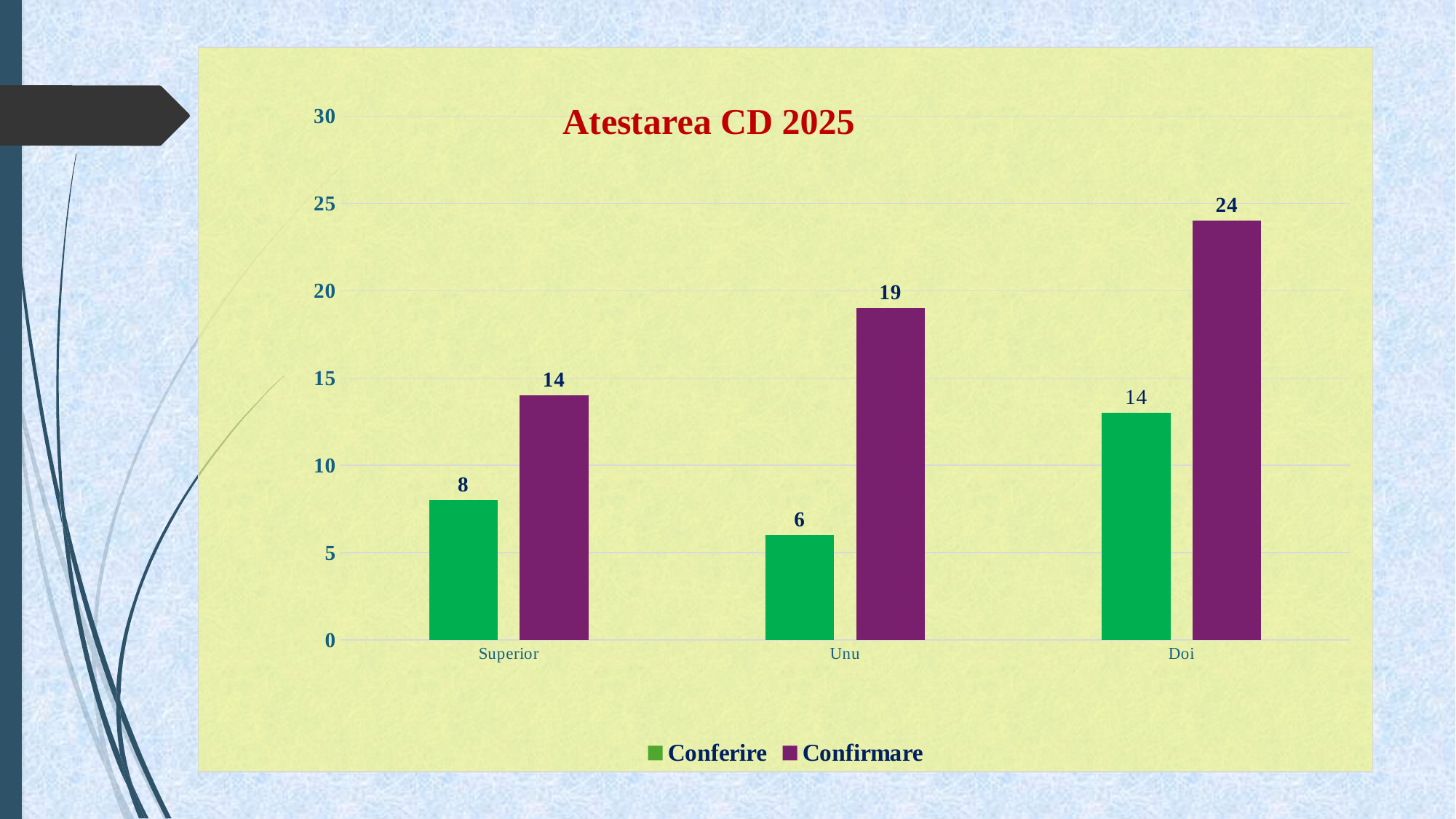
What is the Confirmare value for Unu? 19 What is the Confirmare value for Doi? 24 What kind of chart is shown on the slide? Bar chart What is the title of the chart? Atestarea CD 2025 What is the Conferire value for Unu? 6 How many series does the legend list? 2 How many categories are shown on the x axis? 3 What is the Conferire value for Superior? 8 Which category has the highest Confirmare value? Doi What is the difference between the Confirmare and Conferire values for Unu? 13 Which category has the lowest Conferire value? Unu Which is larger for Superior, Conferire or Confirmare? Confirmare